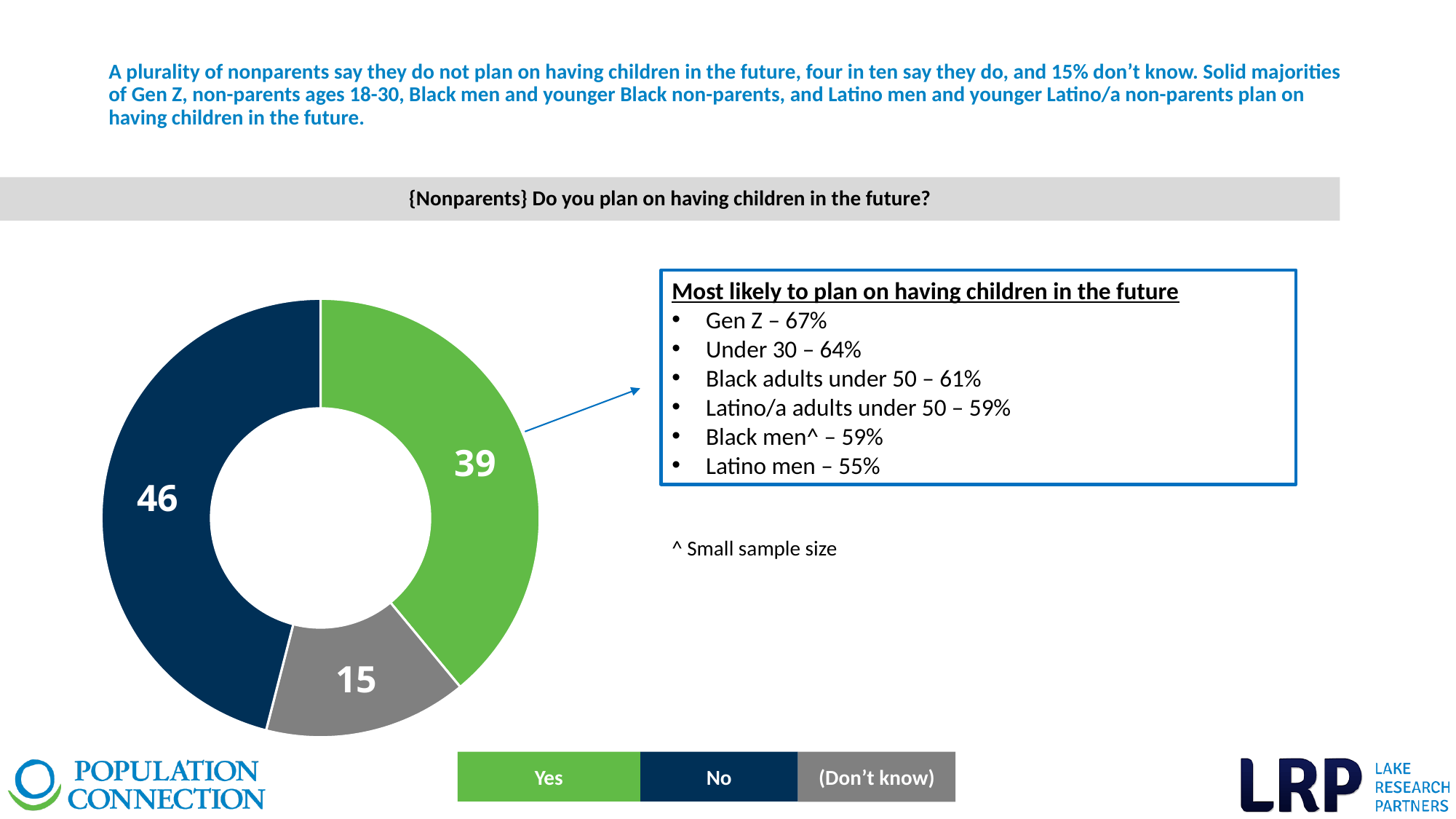
Which response has the largest slice of the chart? No Which is larger, the "Yes" slice or the "No" slice? No What value is shown for the "Yes" slice? 39 How many entries does the legend list? 3 What colour is the "Yes" slice? Green How many slices does the chart have? 3 What value is shown for the "No" slice? 46 What kind of chart is shown on the slide? Donut (pie) chart Which response has the smallest slice of the chart? (Don't know) What value is shown for the "(Don't know)" slice? 15 What is the survey question shown above the chart? {Nonparents} Do you plan on having children in the future? What is the difference between the "No" value and the "Yes" value? 7